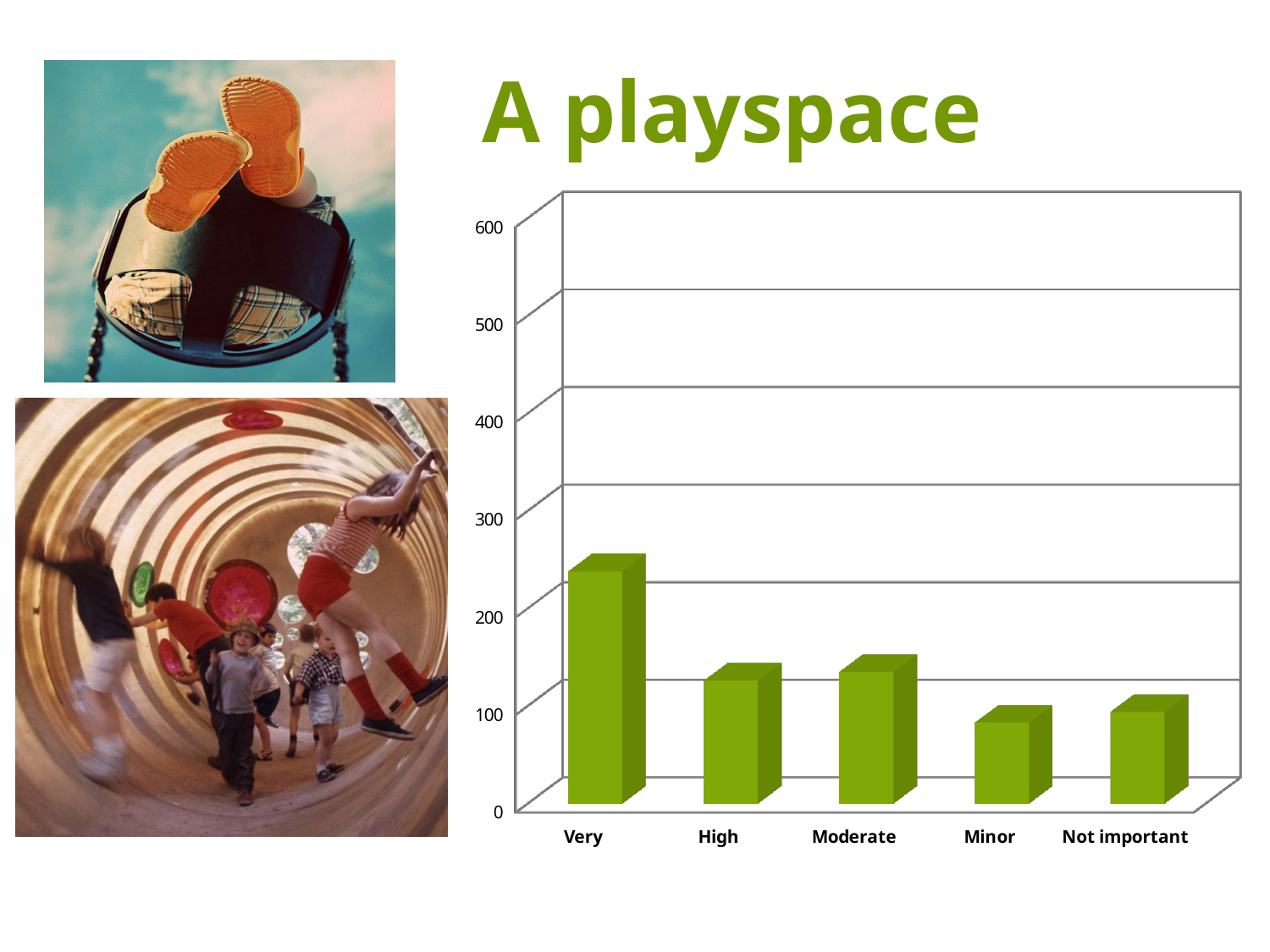
Which is larger, the value for Moderate or the value for Minor? Moderate Is the value for Minor greater or less than 200? less What is the title shown above the chart on the slide? A playspace What colour are the bars in the chart? green Is the value for Moderate greater or less than 100? greater Which category has the highest bar in the chart? Very Is the value for Very greater or less than 300? less How many categories are shown on the x axis of the chart? 5 What kind of chart is shown on the slide? bar chart Which is larger, the value for Very or the value for High? Very